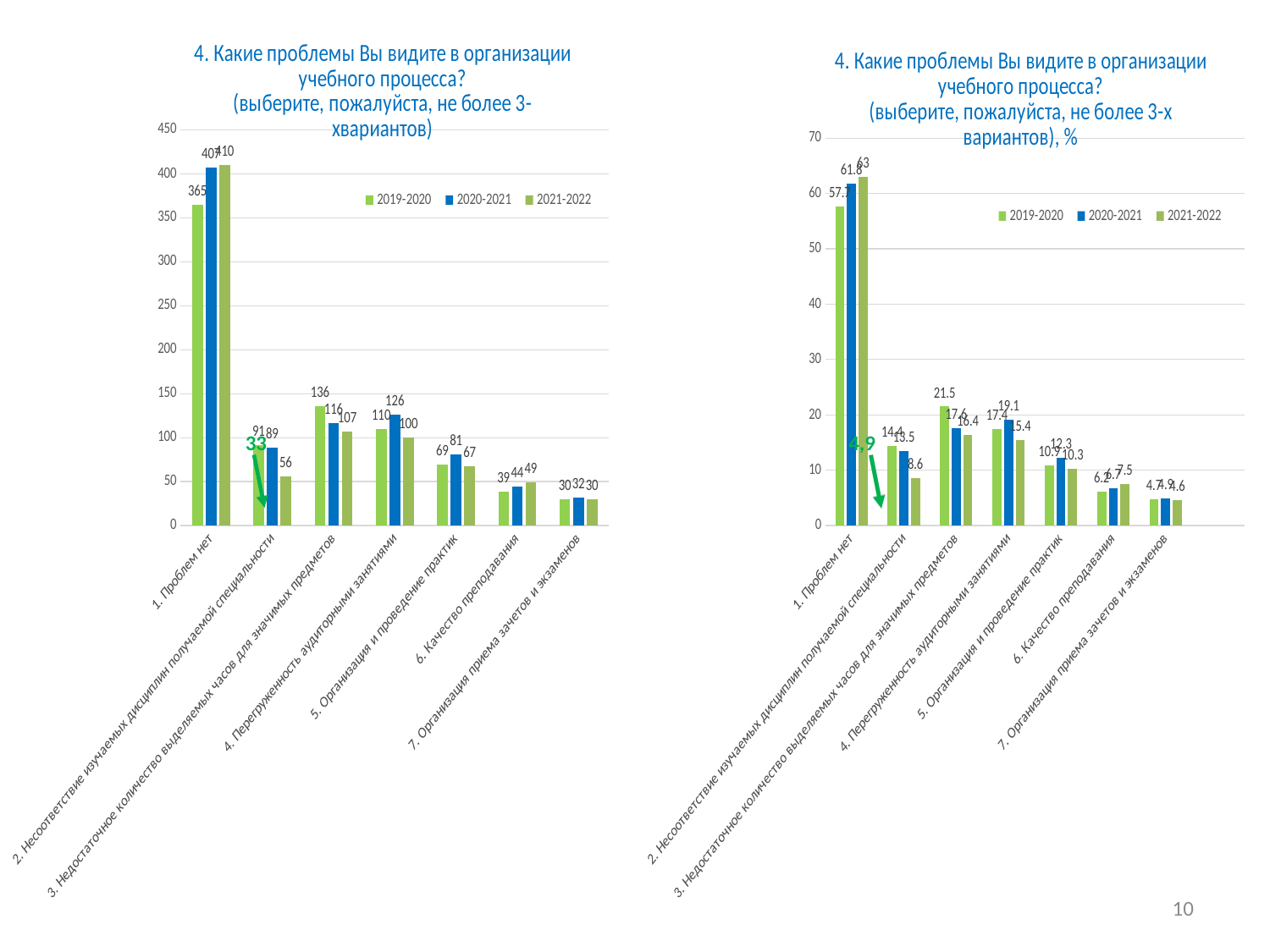
In the left chart (counts), what is the value for '3. Недостаточное количество выделяемых часов для значимых предметов' in the 2019-2020 series? 136 In the right chart (%), is the 2021-2022 value for '6. Качество преподавания' greater or less than the 2019-2020 value? greater In the left chart (counts), how many categories are shown on the x axis? 7 What type of chart is shown on the right side of the slide? bar chart In the left chart (counts), what is the value for '2. Несоответствие изучаемых дисциплин получаемой специальности' in the 2021-2022 series? 56 In the left chart (counts), what is the difference between the 2020-2021 and 2021-2022 values for '4. Перегруженность аудиторными занятиями'? 26 In the right chart (%), what is the value for '3. Недостаточное количество выделяемых часов для значимых предметов' in the 2019-2020 series? 21.5 In the right chart (%), which category has the lowest values across all series? 7. Организация приема зачетов и экзаменов In the right chart (%), what is the value for '1. Проблем нет' in the 2021-2022 series? 63 In the left chart (counts), how many series does the legend list? 3 In the left chart (counts), which category has the highest values across all series? 1. Проблем нет In the left chart (counts), what is the value for '1. Проблем нет' in the 2019-2020 series? 365